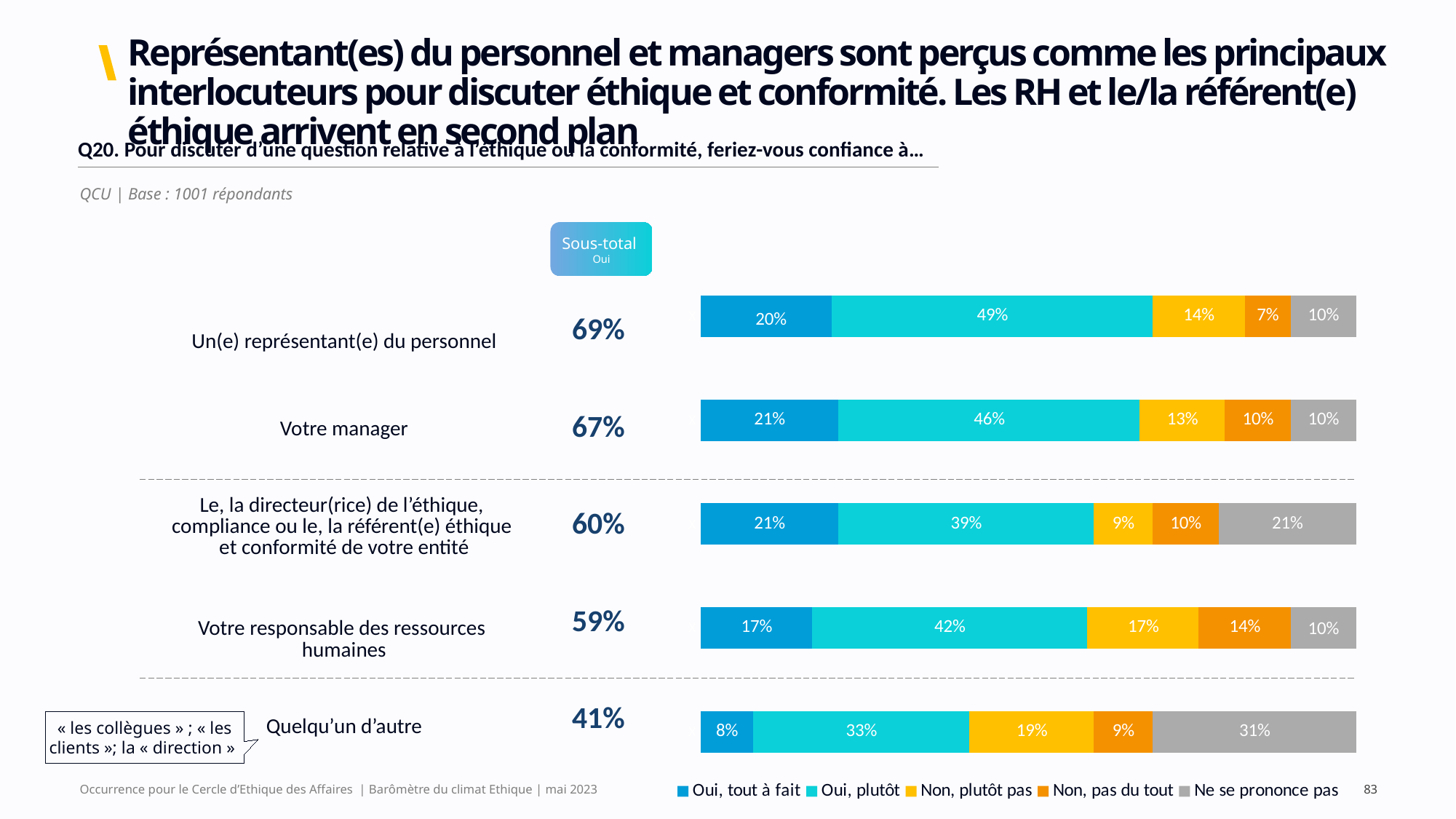
Which category has the highest 'Sous-total Oui'? Un(e) représentant(e) du personnel How many categories (rows) are plotted in the chart? 5 What is the 'Ne se prononce pas' value for 'Quelqu'un d'autre'? 31% What type of chart is shown on the slide? Stacked bar chart What is the 'Non, pas du tout' value for 'Votre responsable des ressources humaines'? 14% How many series does the legend list? 5 Which is larger: the 'Non, plutôt pas' value for 'Votre responsable des ressources humaines' or for 'Votre manager'? Votre responsable des ressources humaines What is the difference between the 'Sous-total Oui' for 'Un(e) représentant(e) du personnel' and for 'Quelqu'un d'autre'? 28 percentage points Which category has the lowest 'Oui, tout à fait' value? Quelqu'un d'autre What is the 'Oui, plutôt' value for 'Un(e) représentant(e) du personnel'? 49% What is the combined 'Oui, tout à fait' and 'Oui, plutôt' total for 'Le, la directeur(rice) de l'éthique, compliance ou le, la référent(e) éthique et conformité de votre entité'? 60% What is the 'Sous-total Oui' for 'Votre manager'? 67%